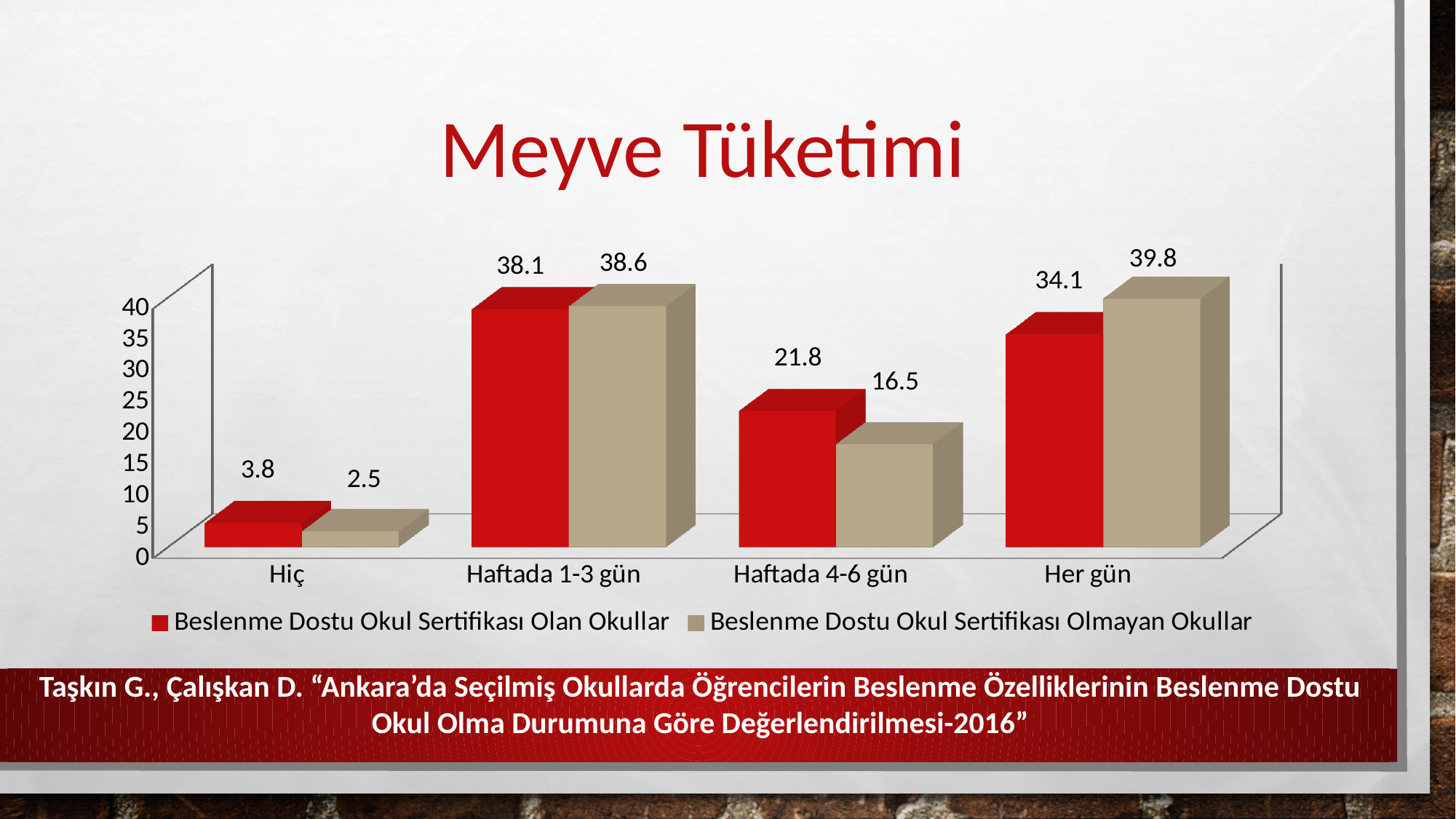
What is the value for 'Hiç' in the 'Beslenme Dostu Okul Sertifikası Olan Okullar' series? 3.8 What kind of chart is shown on the slide? Bar chart What is the difference between the two series for 'Haftada 4-6 gün'? 5.3 What is the value for 'Haftada 4-6 gün' in the 'Beslenme Dostu Okul Sertifikası Olan Okullar' series? 21.8 What is the value for 'Her gün' in the 'Beslenme Dostu Okul Sertifikası Olmayan Okullar' series? 39.8 What is the title of the chart? Meyve Tüketimi For 'Haftada 1-3 gün', which series has the larger value? Beslenme Dostu Okul Sertifikası Olmayan Okullar How many series does the legend list? 2 Which category has the lowest value in the 'Beslenme Dostu Okul Sertifikası Olan Okullar' series? Hiç How many categories are shown on the x axis? 4 What is the difference between the two series for 'Her gün'? 5.7 Which category has the highest value in the 'Beslenme Dostu Okul Sertifikası Olmayan Okullar' series? Her gün